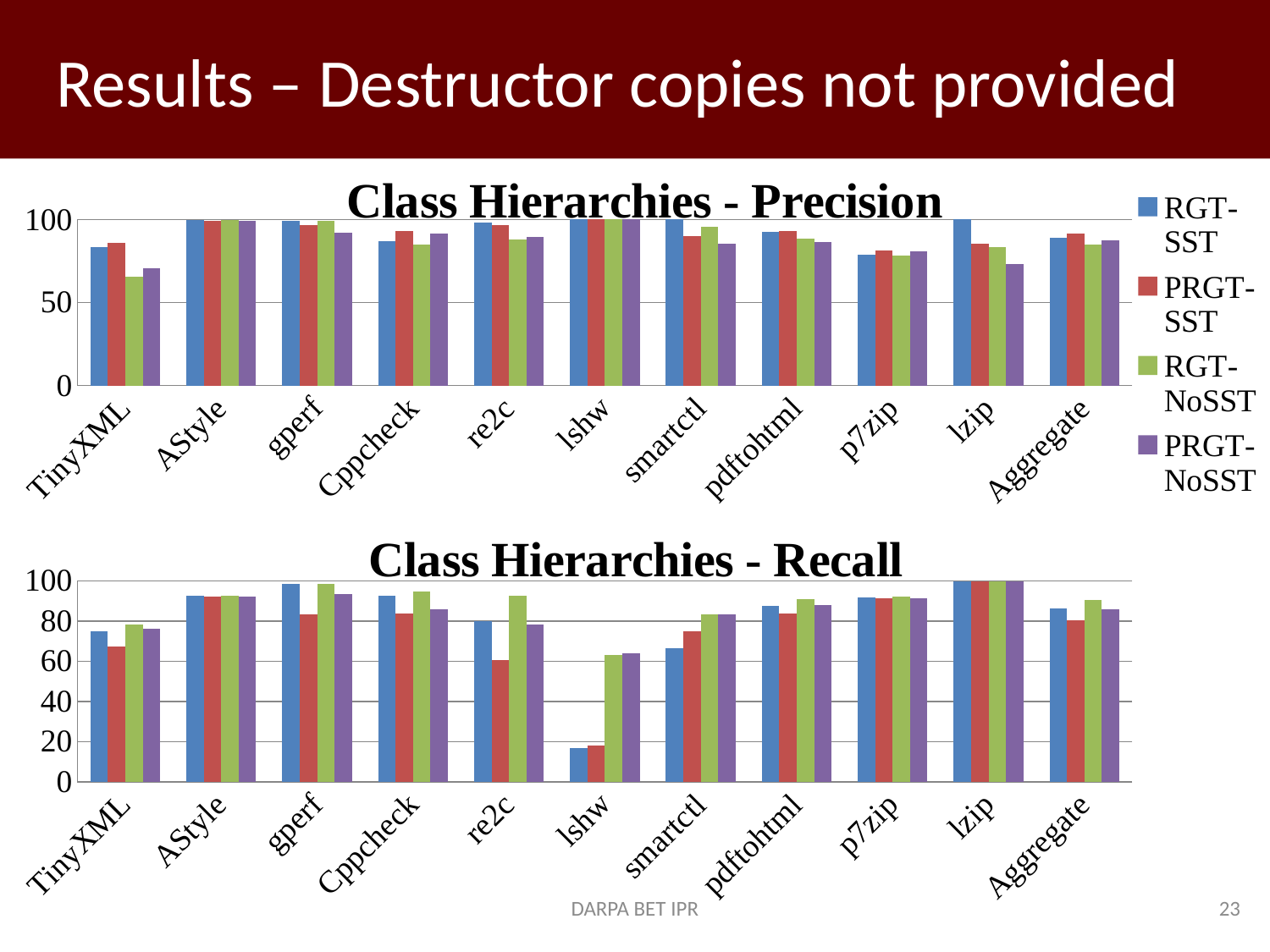
In the 'Class Hierarchies - Precision' chart, which series is shown in green? RGT-NoSST In the 'Class Hierarchies - Precision' chart, is the RGT-NoSST value for TinyXML greater or less than 50? greater In the 'Class Hierarchies - Recall' chart, is the RGT-SST value for lzip greater or less than 80? greater In the 'Class Hierarchies - Recall' chart, is the RGT-SST value for lshw greater or less than 20? less How many categories are shown on the x axis of the 'Class Hierarchies - Recall' chart? 11 How many series does the legend list for the 'Class Hierarchies - Precision' chart? 4 In the 'Class Hierarchies - Precision' chart, which category has the lowest RGT-NoSST value? TinyXML In the 'Class Hierarchies - Recall' chart, for re2c, which is larger: the RGT-NoSST value or the PRGT-SST value? RGT-NoSST What is the title of the lower chart on the slide? Class Hierarchies - Recall In the 'Class Hierarchies - Recall' chart, which category has the lowest RGT-SST value? lshw What kind of chart is the 'Class Hierarchies - Precision' chart? bar chart